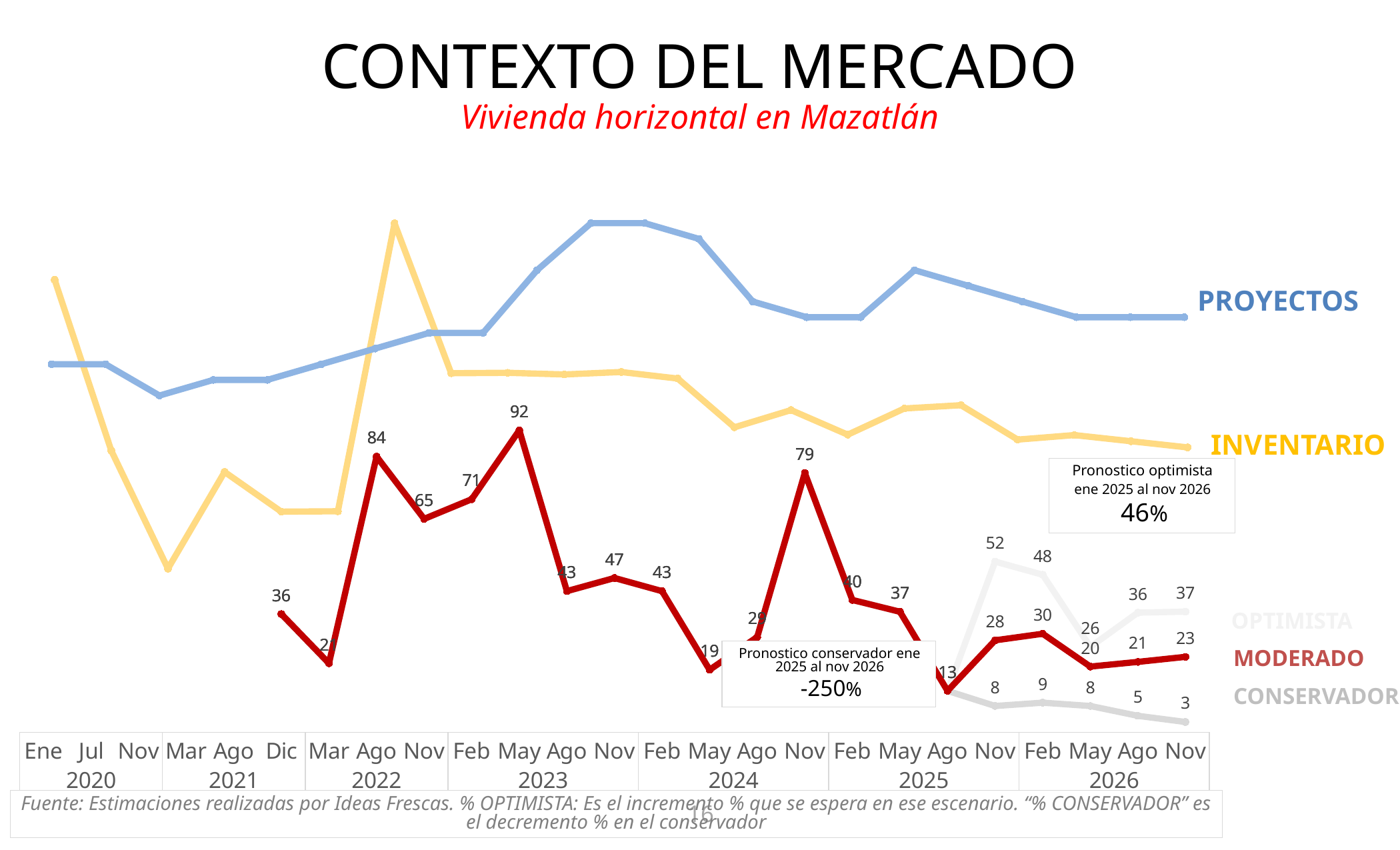
What is the value of the MODERADO line at Nov 2026? 23 What kind of chart is shown on the slide? line chart What percentage is given for the 'Pronostico optimista ene 2025 al nov 2026'? 46% At the end of the chart (Nov 2026), which line is higher: PROYECTOS or INVENTARIO? PROYECTOS What is the value of the OPTIMISTA line at Nov 2026? 37 At Nov 2026, which is larger: the OPTIMISTA value or the MODERADO value? OPTIMISTA What is the highest labelled value on the OPTIMISTA line? 52 What percentage is given for the 'Pronostico conservador ene 2025 al nov 2026'? -250% What is the highest labelled value on the MODERADO line? 92 What is the value of the CONSERVADOR line at Nov 2026? 3 What is the lowest labelled value on the CONSERVADOR line? 3 What is the difference between the two highest labelled values on the MODERADO line, 92 and 84? 8